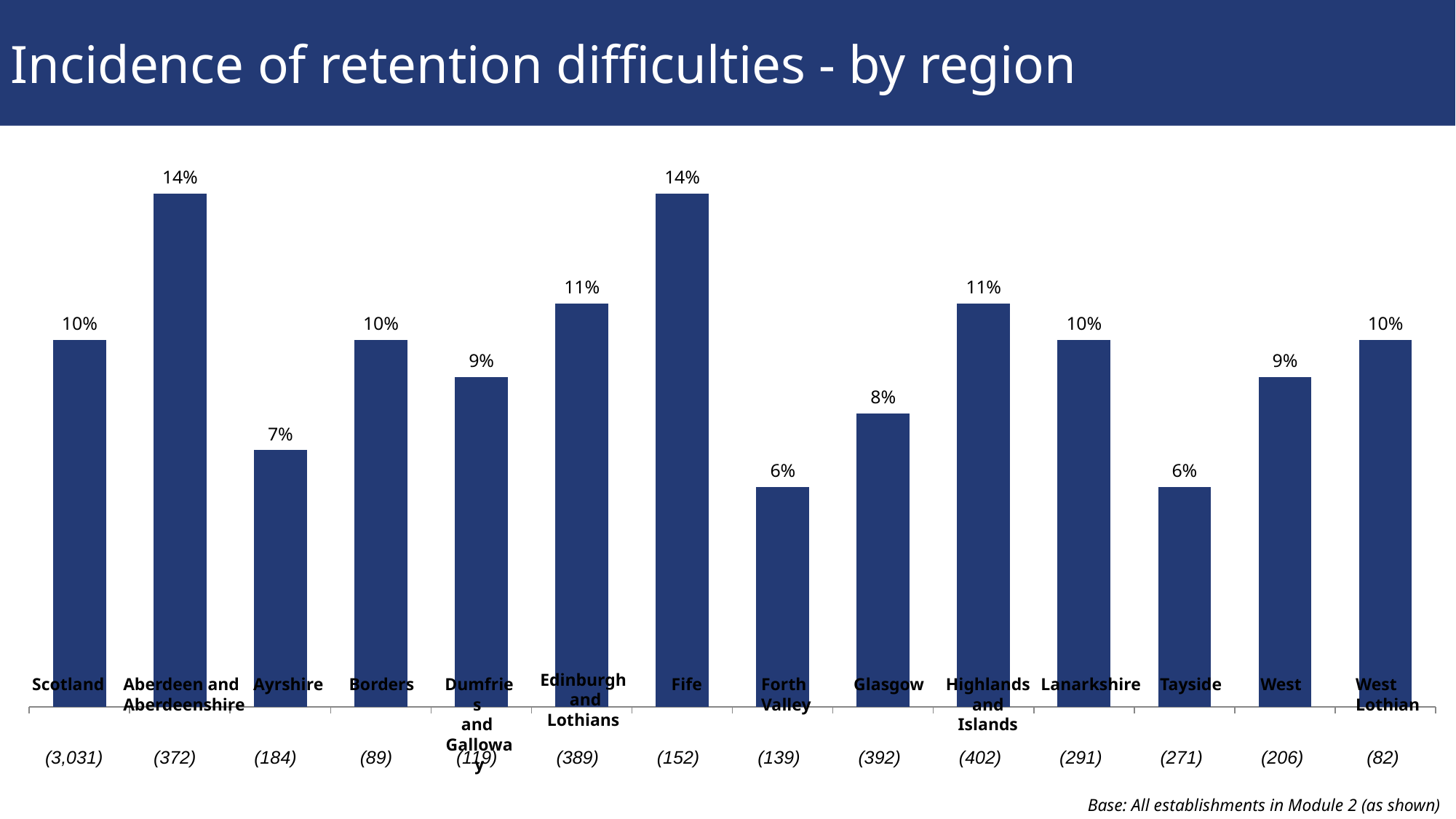
Which two regions share the highest value on the chart? Aberdeen and Aberdeenshire and Fife What kind of chart is shown on the slide? Bar chart What is the value shown for Tayside? 6% What is the value shown for Glasgow? 8% What is the title of the chart? Incidence of retention difficulties - by region How many regions (bars) are shown on the chart? 14 What is the value shown for Scotland overall? 10% What is the incidence of retention difficulties for Fife? 14% What is the base (number of establishments) shown for Highlands and Islands? (402) Which two regions share the lowest value on the chart? Forth Valley and Tayside Which has the higher value, Edinburgh and Lothians or Glasgow? Edinburgh and Lothians What is the difference between the values for Aberdeen and Aberdeenshire and Ayrshire? 7 percentage points